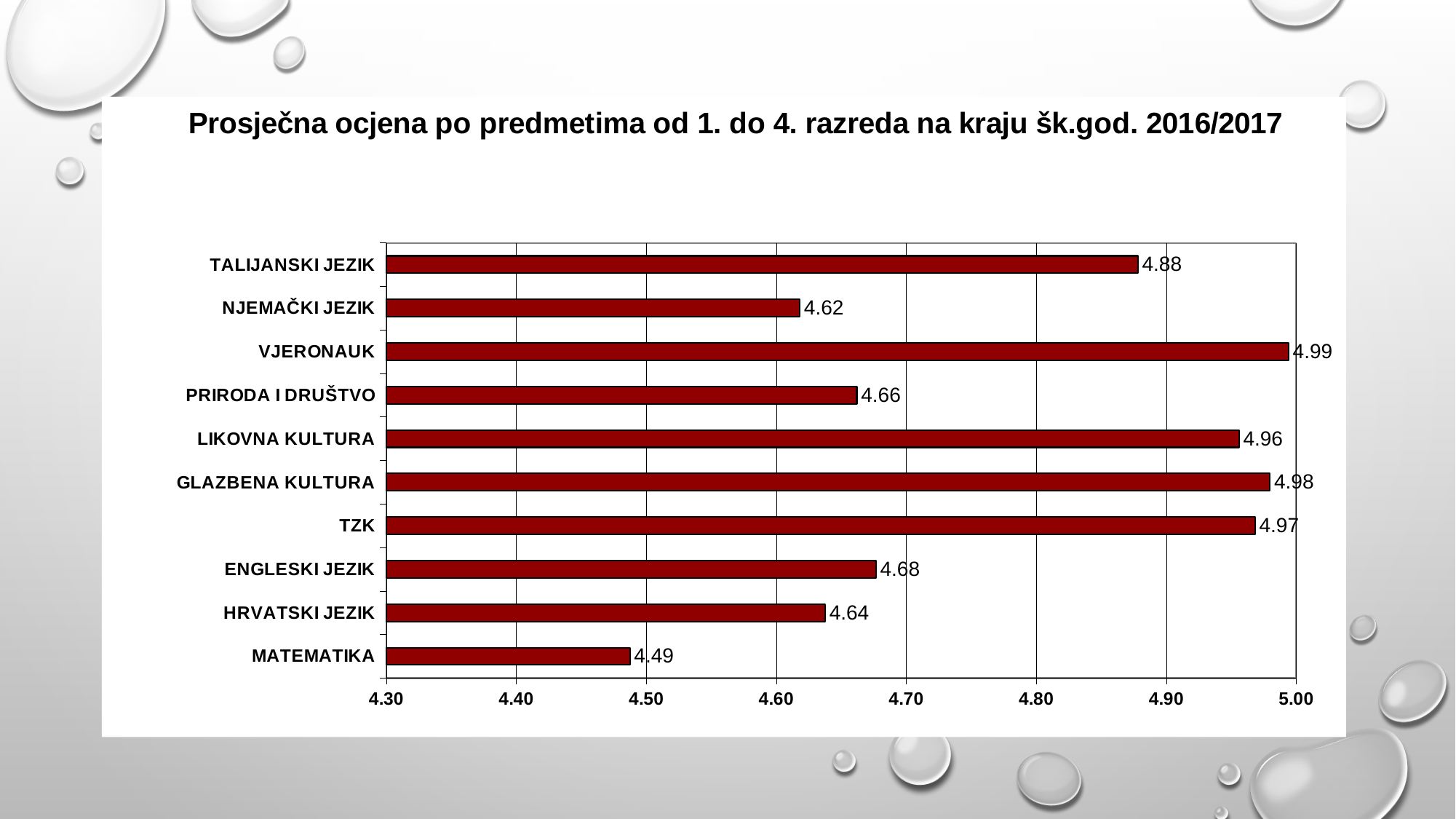
Which subject has the lowest average grade? MATEMATIKA What is the difference between the average grades for TALIJANSKI JEZIK and NJEMAČKI JEZIK? 0.26 Which subject has the highest average grade? VJERONAUK Is the value for GLAZBENA KULTURA greater or less than 4.90? greater Which has a higher average grade, HRVATSKI JEZIK or PRIRODA I DRUŠTVO? PRIRODA I DRUŠTVO What is the average grade for ENGLESKI JEZIK? 4.68 What is the average grade for VJERONAUK? 4.99 What is the average grade for TALIJANSKI JEZIK? 4.88 What is the title of the chart? Prosječna ocjena po predmetima od 1. do 4. razreda na kraju šk.god. 2016/2017 What is the average grade for MATEMATIKA? 4.49 How many subjects are shown in the chart? 10 What kind of chart is shown on the slide? Bar chart